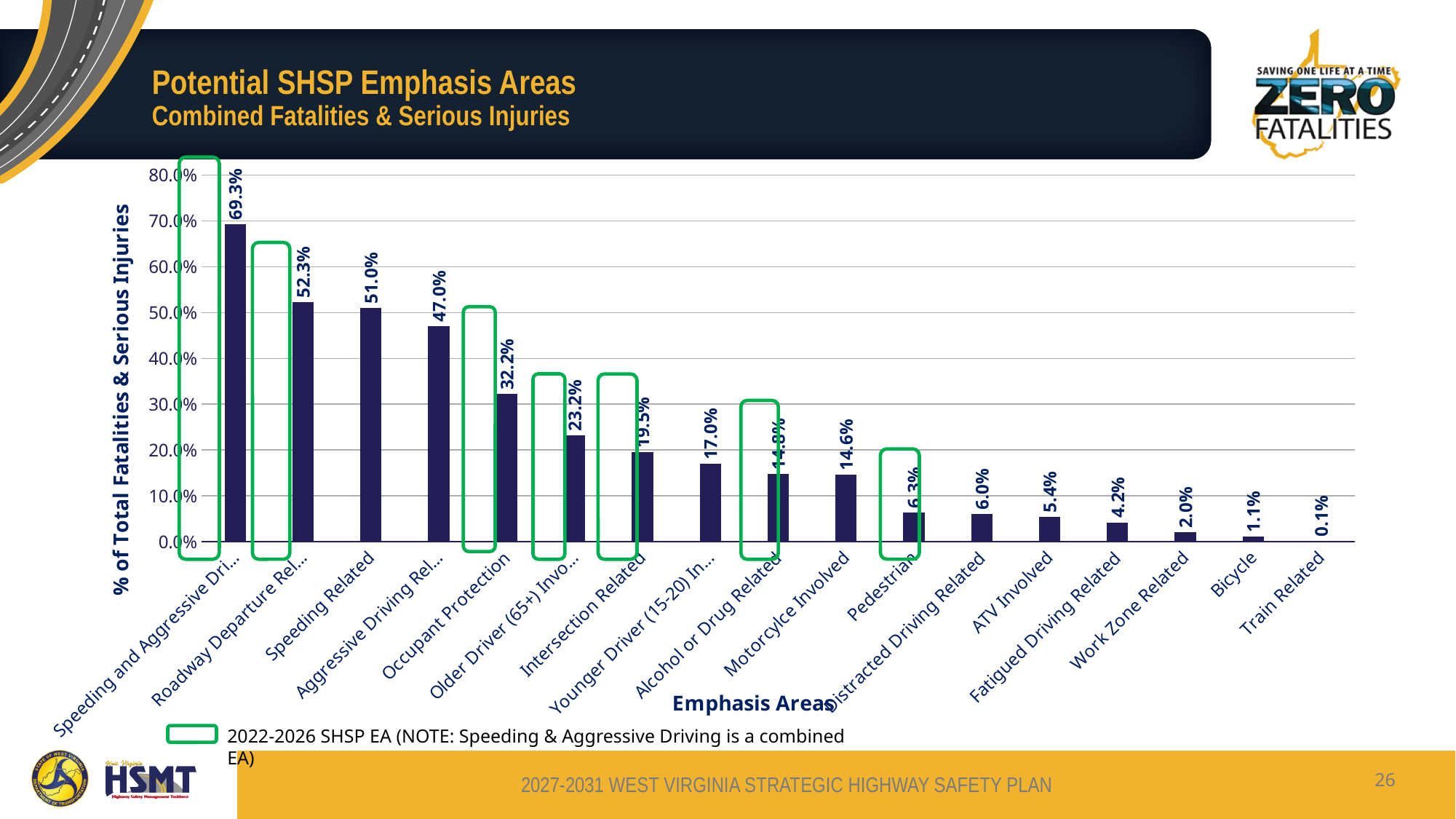
What is the label of the y axis? % of Total Fatalities & Serious Injuries What is the value for Train Related? 0.1% What is the difference between the values for Speeding Related and Occupant Protection? 18.8% What type of chart is shown on the slide? bar chart Which is larger, the value for Motorcylce Involved or the value for Distracted Driving Related? Motorcylce Involved What is the value for Pedestrian? 6.3% What is the value for Occupant Protection? 32.2% Which emphasis area has the highest percentage of total fatalities and serious injuries? Speeding and Aggressive Driving Is the value for Aggressive Driving Related greater or less than 40.0%? greater Which emphasis area has the lowest percentage of total fatalities and serious injuries? Train Related How many emphasis areas are plotted on the x axis? 17 What is the value for Speeding Related? 51.0%